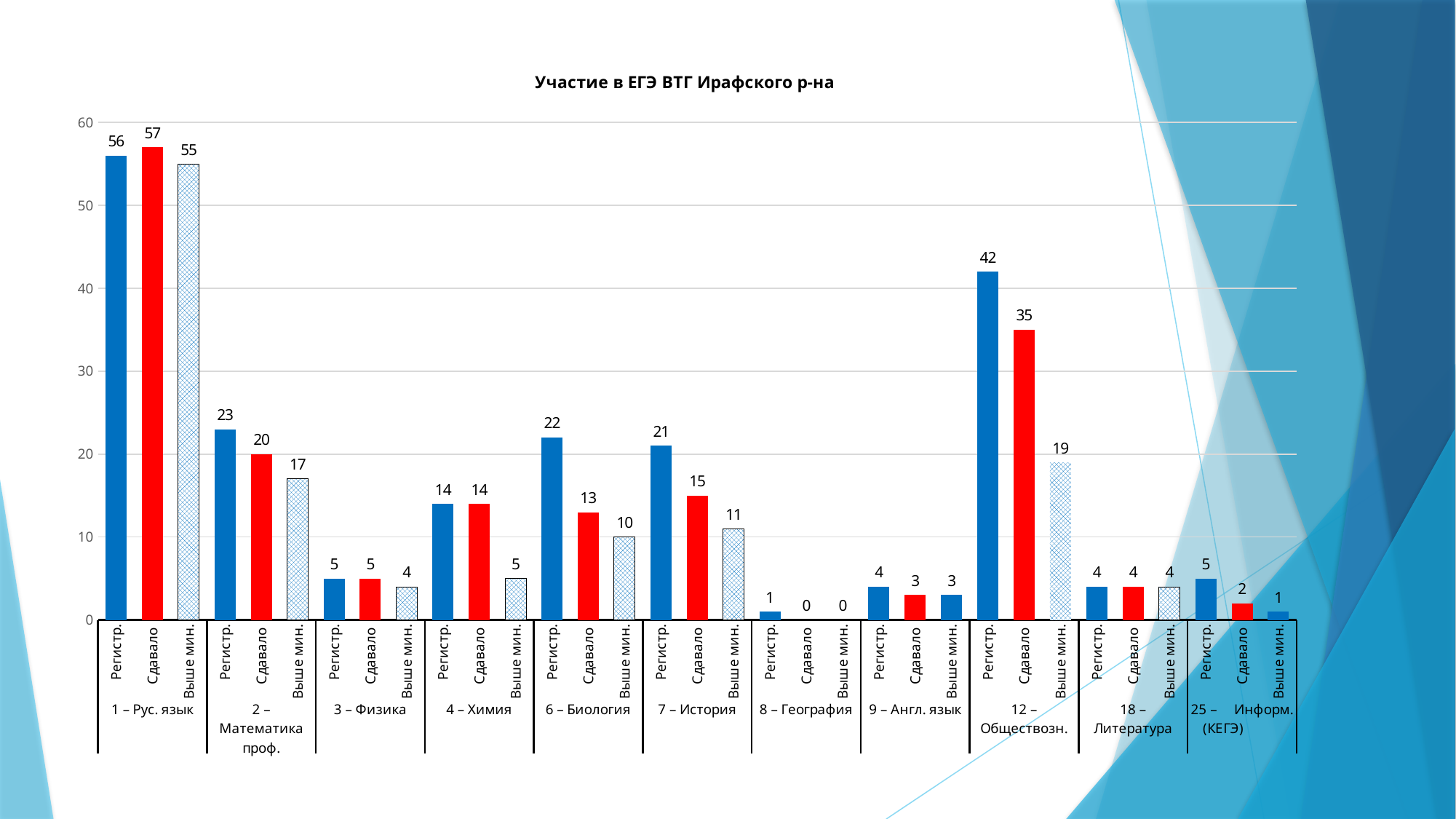
Which subject group has the highest "Регистр." value? 1 – Рус. язык What is the value of "Выше мин." for "12 – Обществозн."? 19 What is the value of "Регистр." for "6 – Биология"? 22 What type of chart is shown on the slide? bar chart What is the title of the chart? Участие в ЕГЭ ВТГ Ирафского р-на What is the difference between "Сдавало" and "Выше мин." for "4 – Химия"? 9 Which subject group has the lowest "Сдавало" value? 8 – География What is the value of "Сдавало" for "1 – Рус. язык"? 57 Which is larger for "7 – История": "Регистр." or "Выше мин."? Регистр. What is the difference between "Регистр." and "Сдавало" for "12 – Обществозн."? 7 What is the value of "Сдавало" for "25 – Информ. (КЕГЭ)"? 2 How many subject groups are shown along the x axis? 11